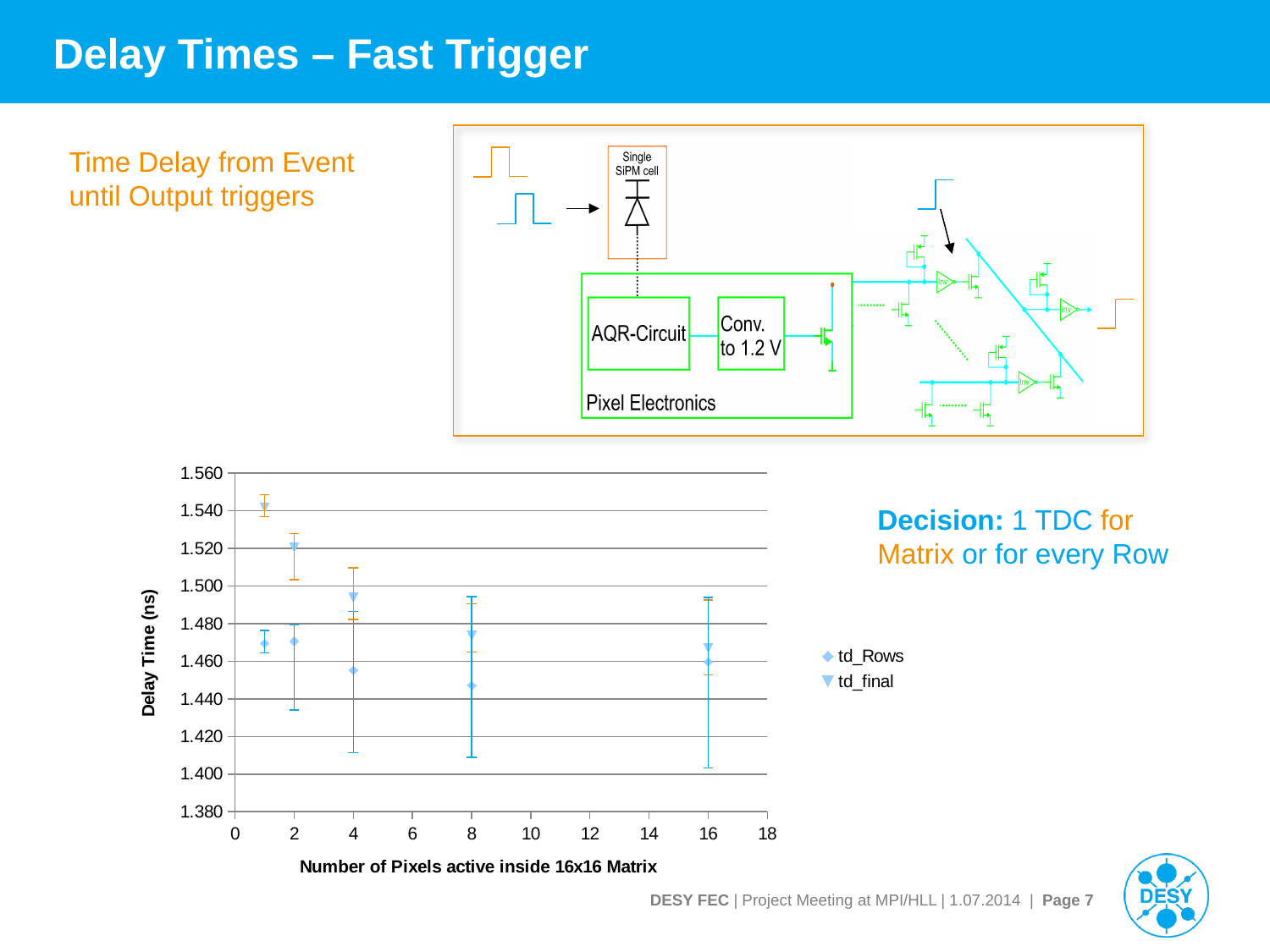
How many data points are plotted for the td_final series? 5 What kind of chart is shown on the slide? scatter chart Is the td_Rows value at 16 active pixels greater or less than 1.480 ns? less How many series does the chart legend list? 2 What is the title of the chart's x axis? Number of Pixels active inside 16x16 Matrix At 1 active pixel, which series has the larger delay time, td_Rows or td_final? td_final Is the td_final value at 2 active pixels greater or less than 1.500 ns? greater Is the td_final value at 1 active pixel greater or less than 1.520 ns? greater What are the two series named in the chart legend? td_Rows and td_final At which number of active pixels is the td_final delay time highest? 1 Does the td_final delay time rise or fall as the number of active pixels increases? fall